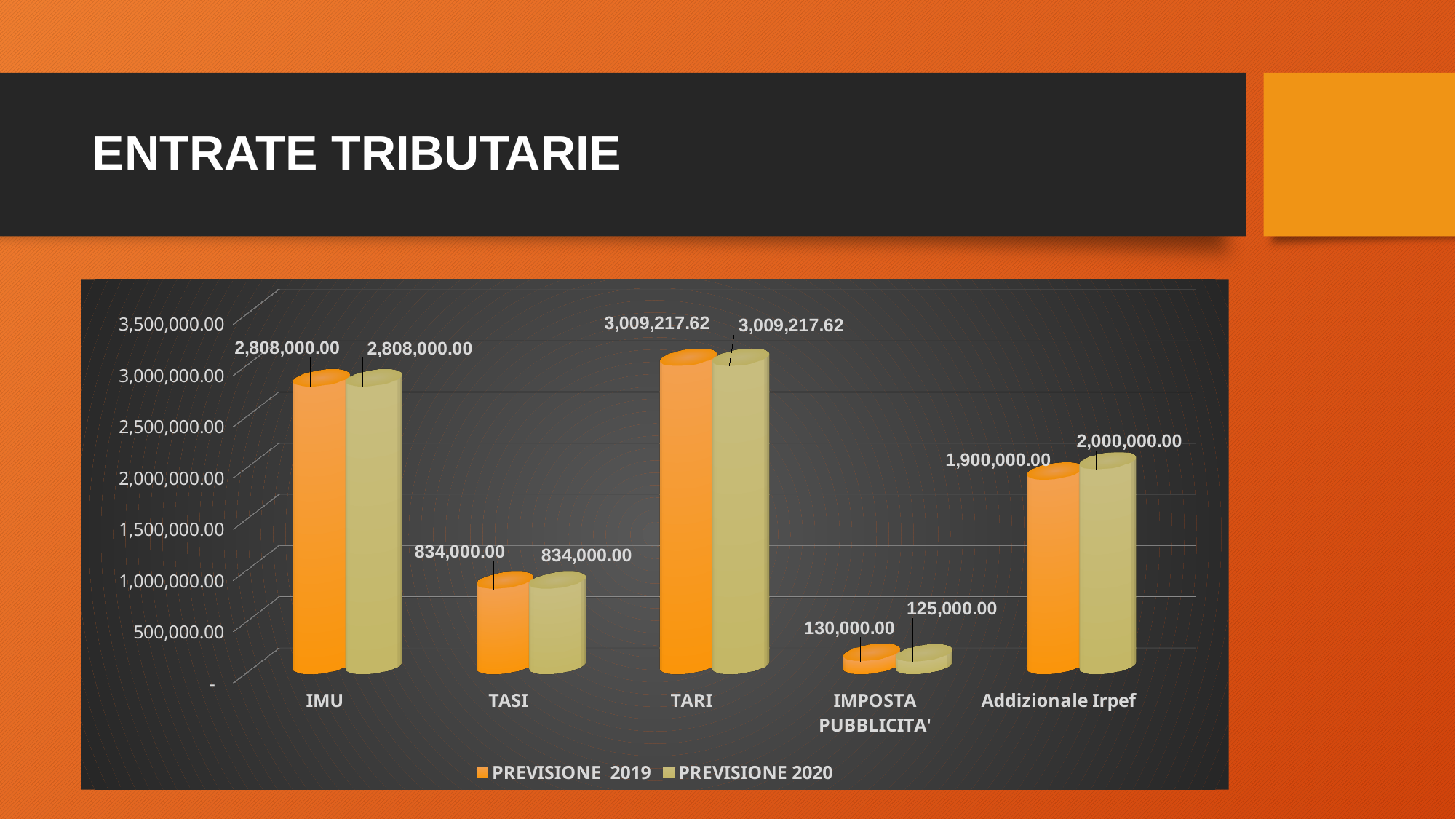
What is the PREVISIONE 2020 value for TARI? 3,009,217.62 What is the title of the slide containing the chart? ENTRATE TRIBUTARIE Which category has the highest PREVISIONE 2019 value? TARI Which is larger for IMPOSTA PUBBLICITA': the PREVISIONE 2019 value or the PREVISIONE 2020 value? PREVISIONE 2019 What is the PREVISIONE 2019 value for IMU? 2,808,000.00 How many series does the legend list? 2 Which category has the lowest PREVISIONE 2020 value? IMPOSTA PUBBLICITA' What is the difference between the PREVISIONE 2020 and PREVISIONE 2019 values for Addizionale Irpef? 100,000.00 What kind of chart is shown on the slide? Bar chart What is the PREVISIONE 2019 value for IMPOSTA PUBBLICITA'? 130,000.00 What is the PREVISIONE 2020 value for Addizionale Irpef? 2,000,000.00 How many categories are shown on the x axis? 5